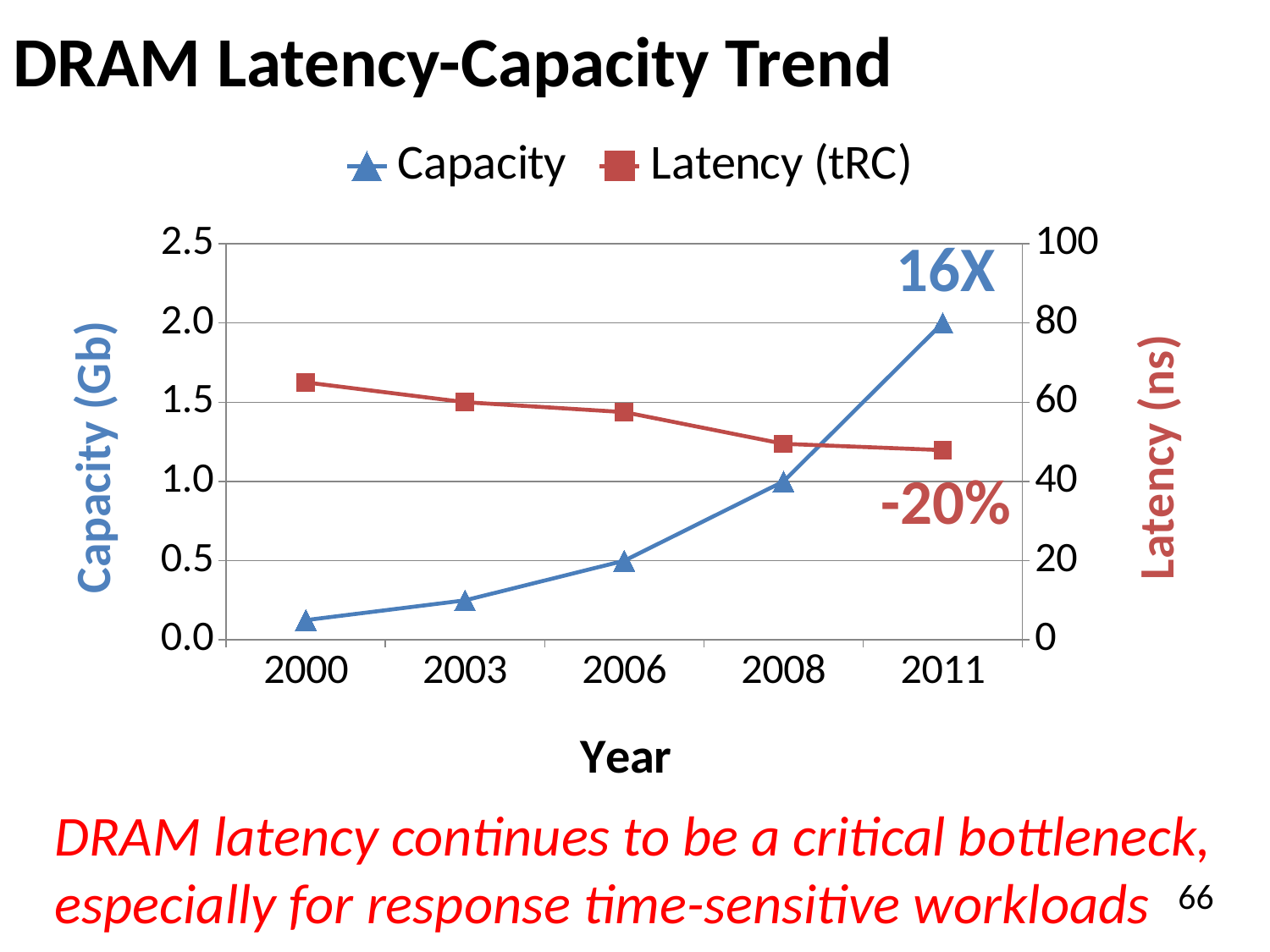
How many years are plotted along the x axis? 5 Which year has the highest Capacity? 2011 Is the Latency (tRC) value for 2000 greater or less than 60? greater What is the Capacity value for 2011? 2.0 Does Latency (tRC) rise or fall from 2000 to 2011? fall Is the Latency (tRC) value for 2011 greater or less than 60? less How many series does the legend list? 2 What kind of chart is shown on the slide? line chart Which year has the highest Latency (tRC)? 2000 What is the Capacity value for 2008? 1.0 What is the Latency (tRC) value for 2003? 60 Is the Capacity value for 2000 greater or less than 0.5? less